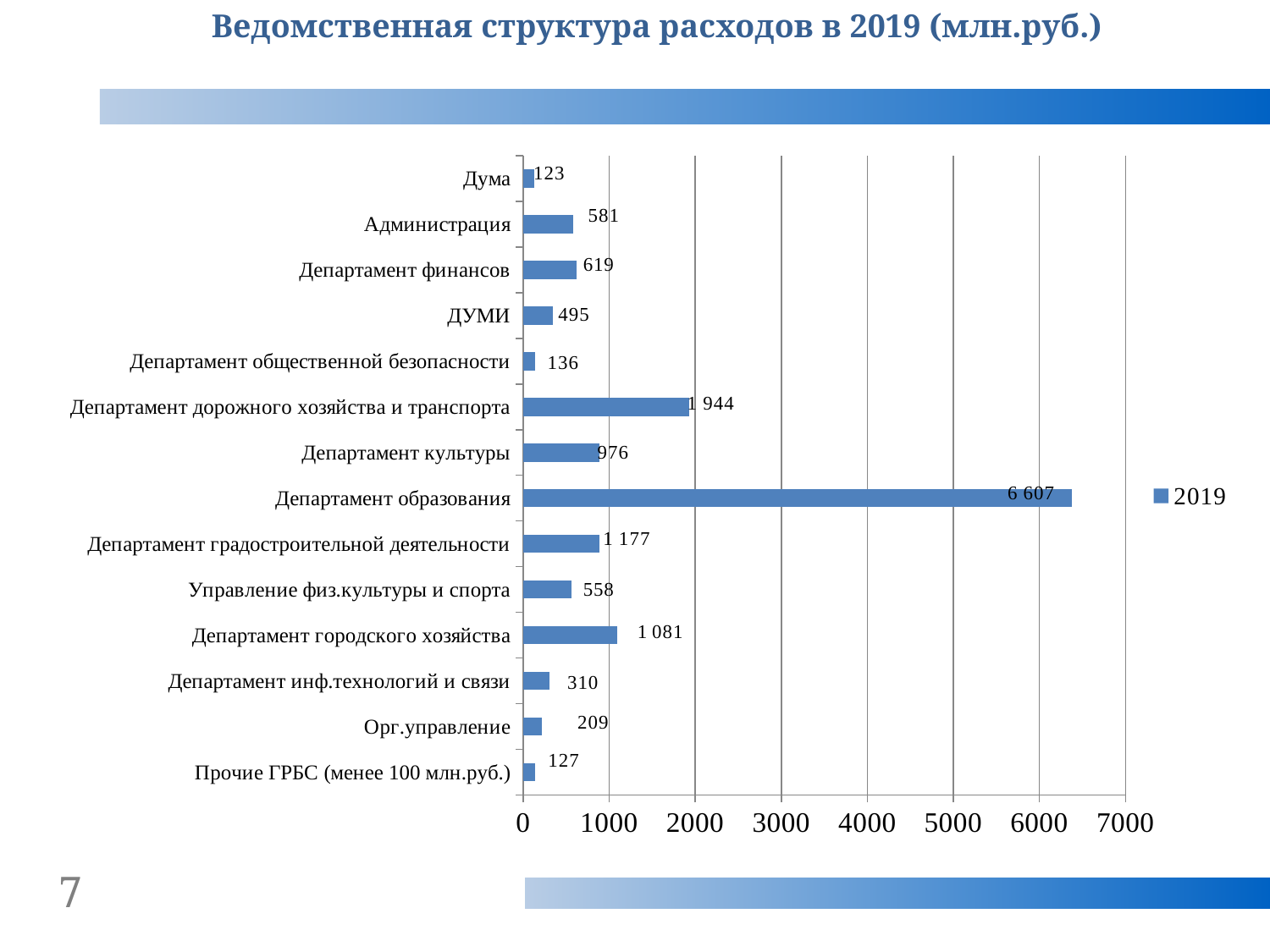
What is the difference between the values for Департамент образования and Департамент дорожного хозяйства и транспорта? 4 663 What is the value for ДУМИ? 495 How many series does the legend list? 1 What is the value for Департамент дорожного хозяйства и транспорта? 1 944 Which is larger, the value for Департамент финансов or the value for Администрация? Департамент финансов Which category has the highest value? Департамент образования Is the value for Департамент городского хозяйства greater or less than 1000? greater What is the value for Орг.управление? 209 Which category has the lowest value? Дума What kind of chart is shown on the slide? bar chart What is the value for Департамент образования? 6 607 How many categories are shown on the chart? 14